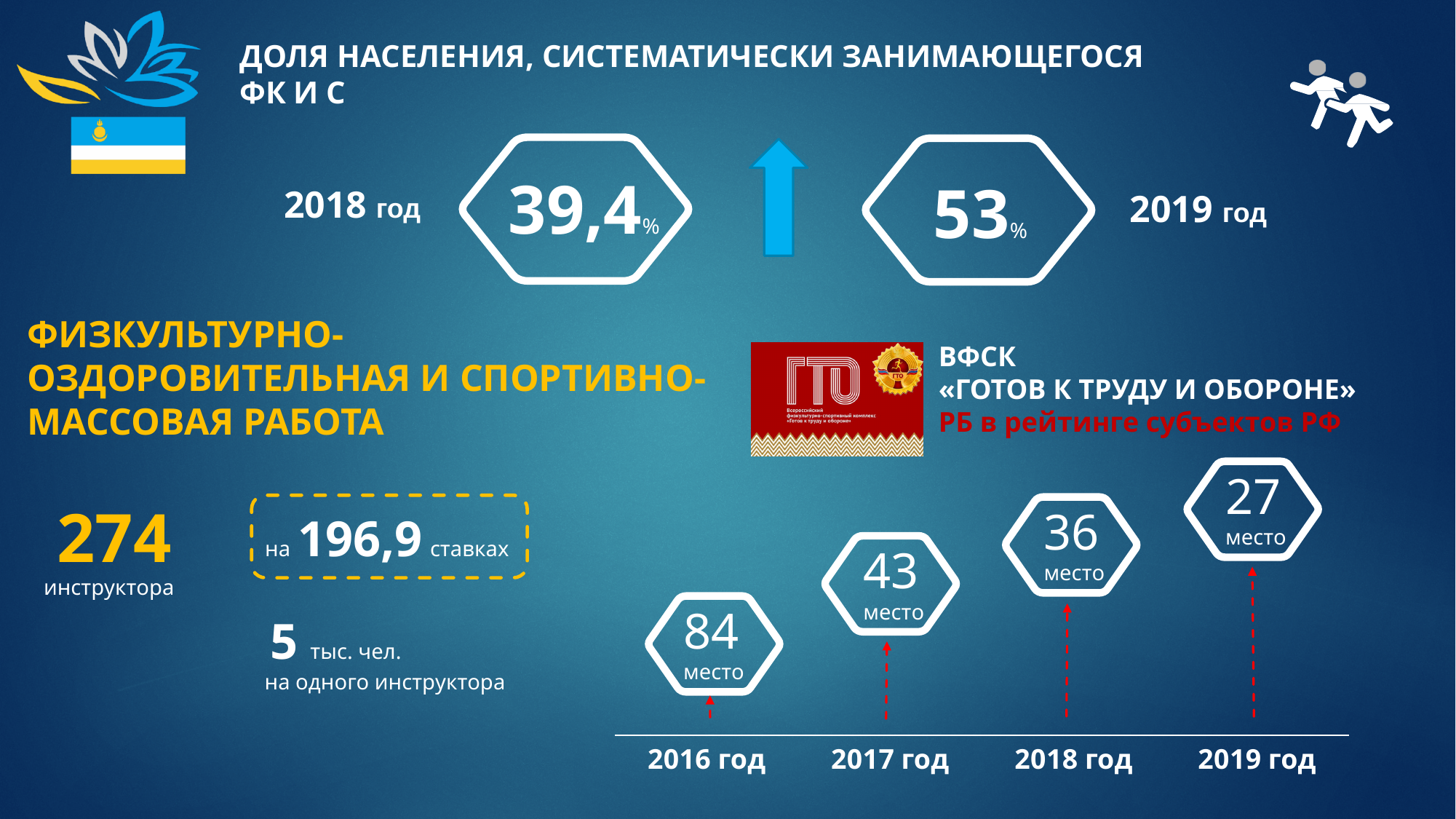
In the GTO ranking chart at the bottom right, by how many places did the ranking number change from 2016 to 2019? 57 In the top chart on the share of population systematically engaged in physical culture and sport, by how many percentage points did the share grow from 2018 to 2019? 13,6% In the GTO ranking chart at the bottom right, which year has the lowest place number? 2019 год In the GTO ranking chart at the bottom right, which is larger, the place number for 2017 or for 2018? 2017 In the top chart on the share of population systematically engaged in physical culture and sport, what is the value for 2018? 39,4% In the GTO ranking chart at the bottom right, which year has the highest place number? 2016 год In the GTO ranking chart at the bottom right, do the place numbers rise or fall from 2016 to 2019? fall In the GTO ranking chart at the bottom right, how many years are shown along the axis? 4 In the top chart on the share of population systematically engaged in physical culture and sport, what is the value for 2019? 53% In the GTO ranking chart at the bottom right, what place did the republic hold in 2019? 27 место In the GTO ranking chart at the bottom right, what place is shown for 2017? 43 место In the GTO ranking chart at the bottom right, what place did the republic hold in 2016? 84 место